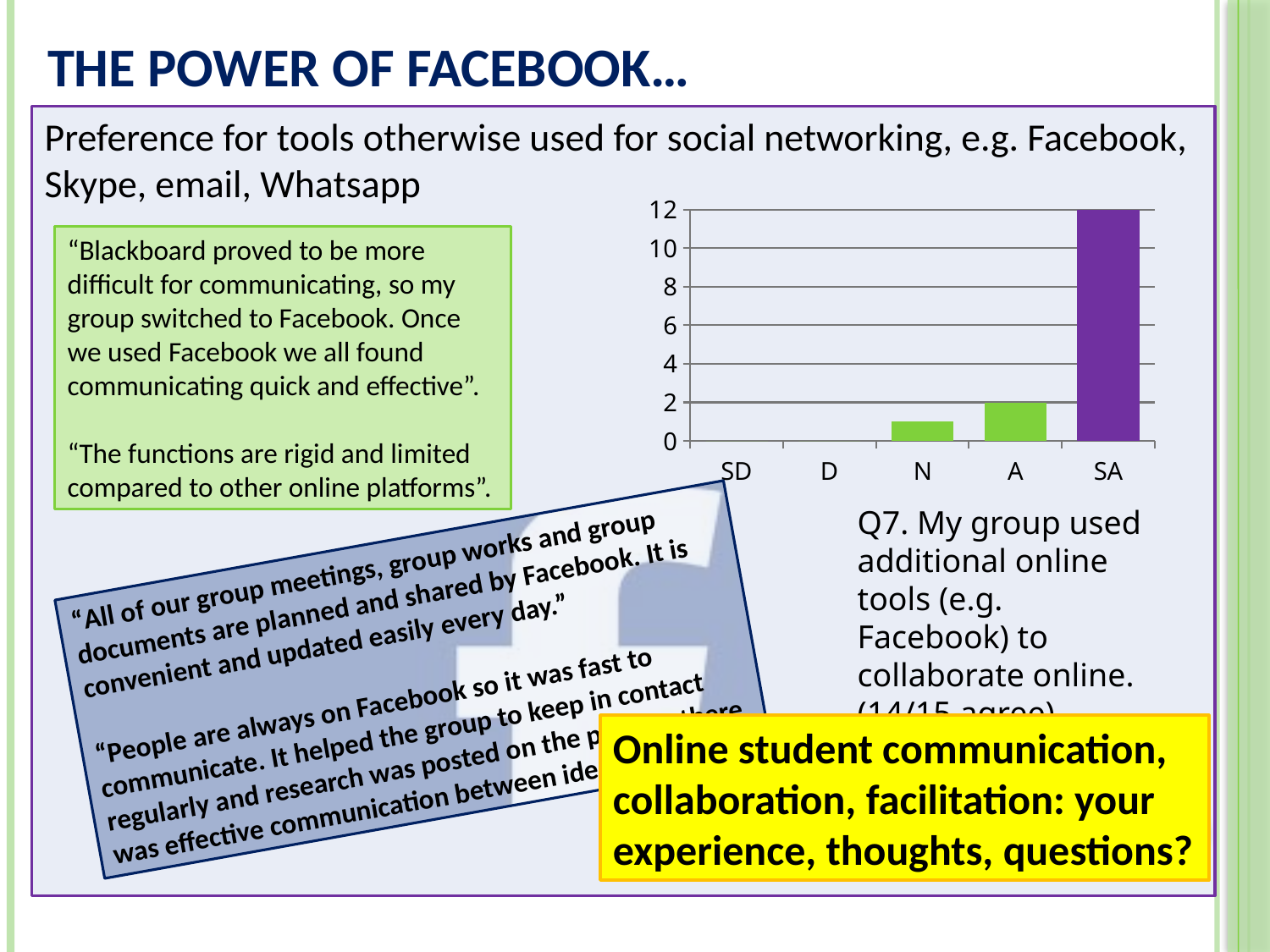
What is the combined value of A and SA? 14 How many categories in the chart have no visible bar? 2 Which category has the highest value in the chart? SA How many categories are shown on the x axis of the chart? 5 Is the value for SA greater or less than 10? greater Which has the larger value, A or N? A Is the value for N greater or less than 2? less What is the difference between the values for SA and A? 10 What kind of chart is shown on the slide? bar chart Which survey question does the chart relate to, according to the text beside it? Q7. My group used additional online tools (e.g. Facebook) to collaborate online. What is the value for A in the chart? 2 What is the value for SA in the chart? 12